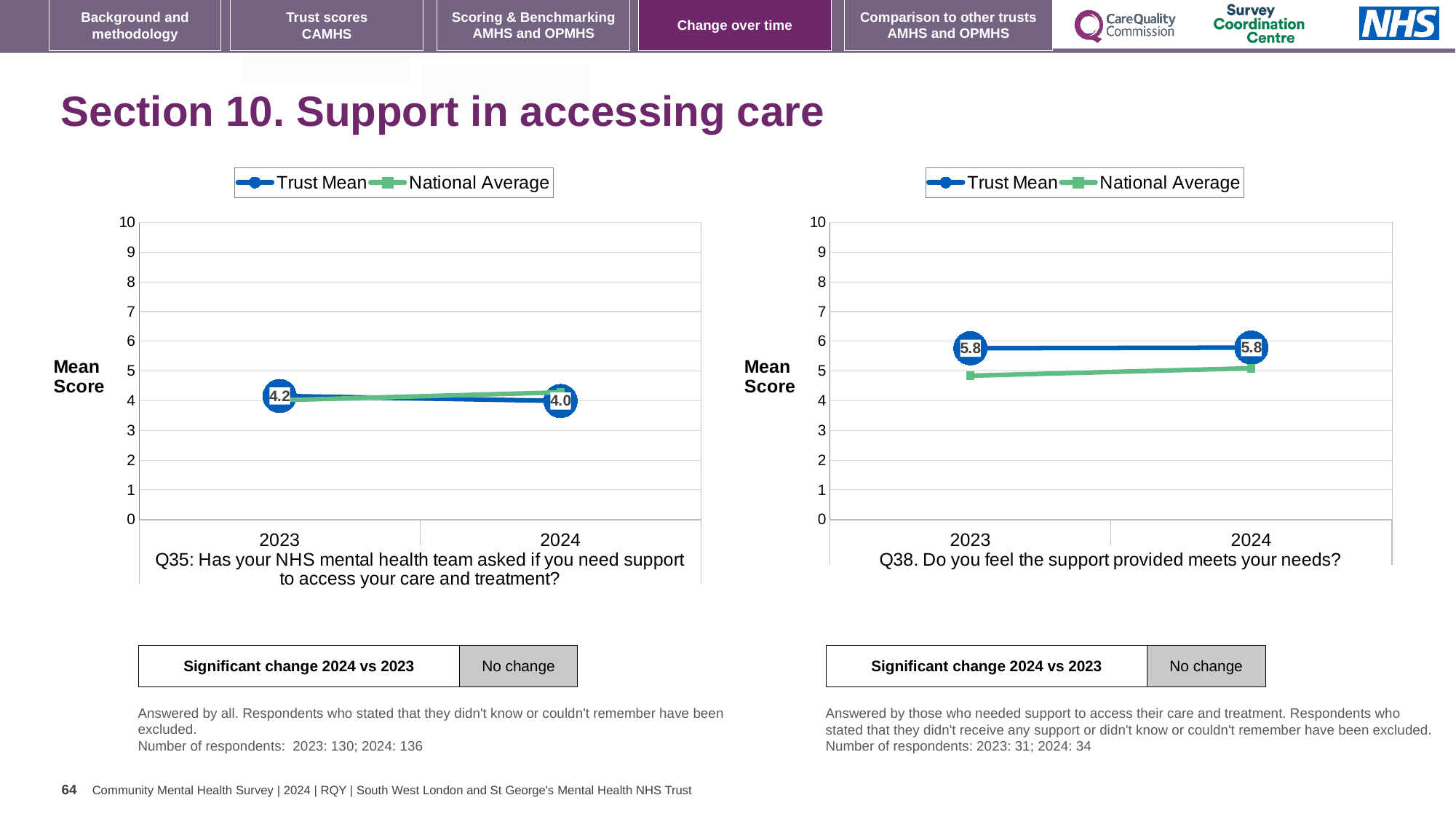
In the Q38 chart, is the National Average for 2023 greater or less than 5? less In the Q35 chart, what is the difference between the Trust Mean scores for 2023 and 2024? 0.2 In the Q38 chart, which is larger for 2024, the Trust Mean or the National Average? Trust Mean In the Q35 chart, does the Trust Mean rise or fall from 2023 to 2024? fall In the Q35 chart, what is the Trust Mean score for 2023? 4.2 How many years are shown on the x axis of the Q38 chart? 2 In the Q35 chart, what is the Trust Mean score for 2024? 4.0 What are the two series named in the legend of the Q38 chart? Trust Mean and National Average In the Q38 chart, what is the Trust Mean score for 2024? 5.8 How many series does the legend of the Q35 chart list? 2 What kind of chart is the Q38 chart? line chart In the Q38 chart, does the National Average rise or fall from 2023 to 2024? rise